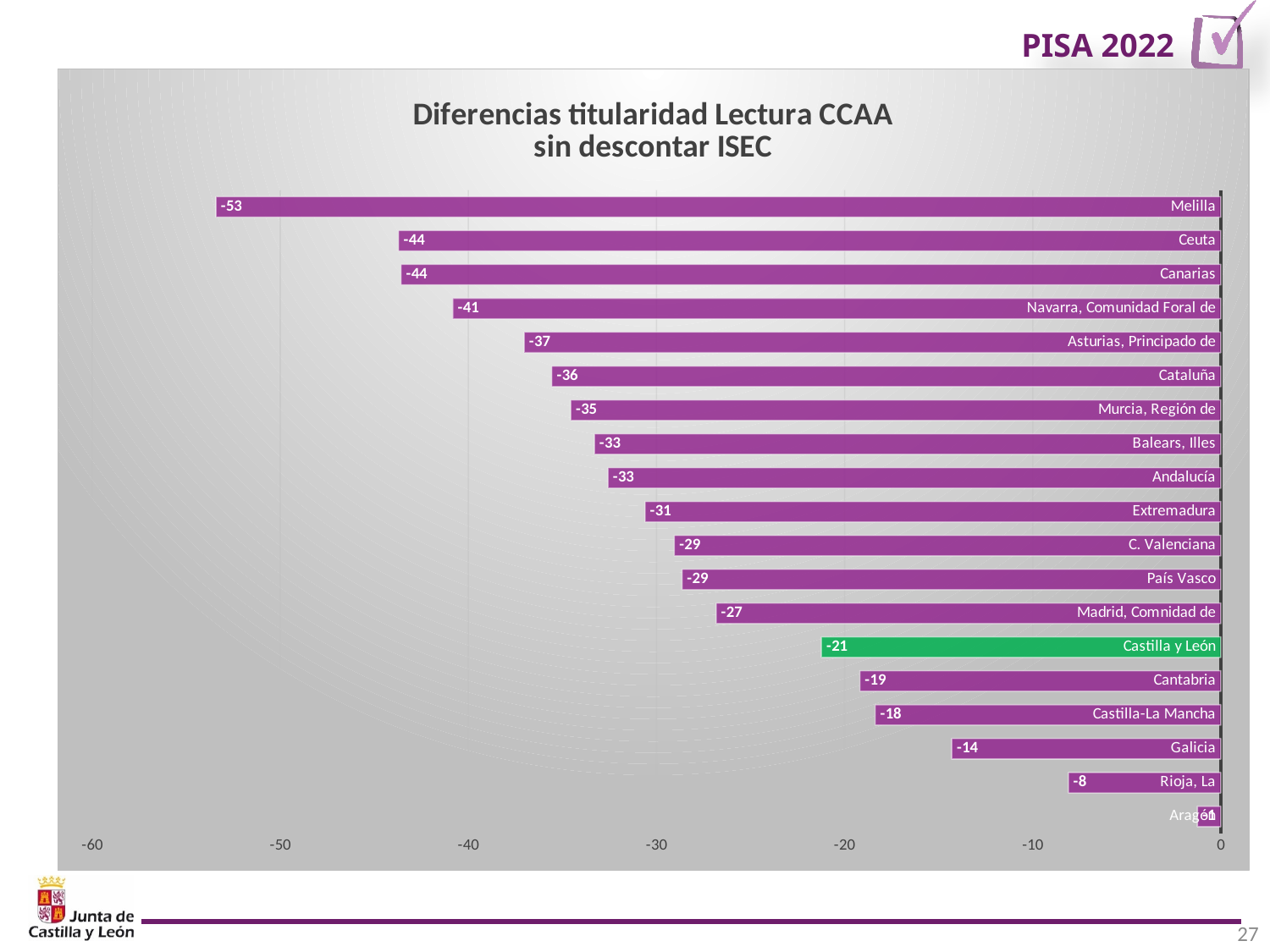
Which region's bar is coloured green instead of purple? Castilla y León Which region has the longest bar (the most negative value)? Melilla What is the value for Castilla y León? -21 What is the value for Melilla? -53 What is the difference between the values for Cantabria and Rioja, La? 11 Which has a more negative value, Cataluña or Madrid, Comnidad de? Cataluña What is the difference between the values for Melilla and Castilla y León? 32 Which has a more negative value, Galicia or Castilla-La Mancha? Castilla-La Mancha What is the value for Navarra, Comunidad Foral de? -41 How many regions are shown in the chart? 19 What kind of chart is shown on the slide? Bar chart What is the value for Galicia? -14